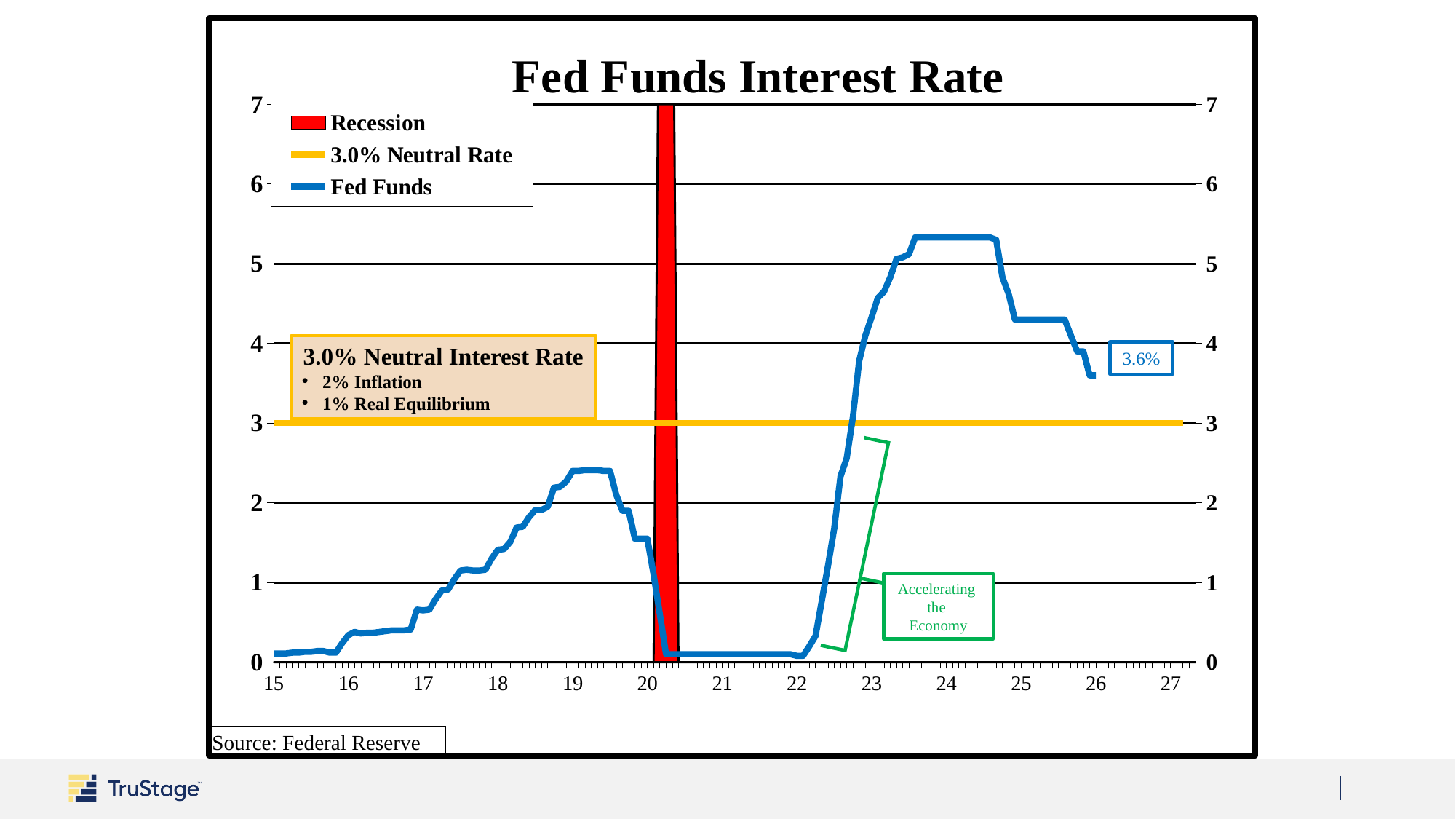
What kind of chart is shown on the slide? line chart Does the Fed Funds line rise or fall between 2022 and 2024? rise Around which year does the Fed Funds line reach its highest level? 2024 What is the title of the chart? Fed Funds Interest Rate Is the Fed Funds rate in 2024 greater or less than 5? greater Is the Fed Funds rate in 2021 greater or less than 1? less Is the Fed Funds rate at its 2019 peak greater or less than 3? less How many entries does the chart's legend list? 3 Which is higher, the Fed Funds rate in 2024 or in 2019? 2024 What value is labelled at the end of the Fed Funds line? 3.6% Does the Fed Funds line rise or fall between 2024 and 2026? fall What level is the neutral rate line drawn at? 3.0%